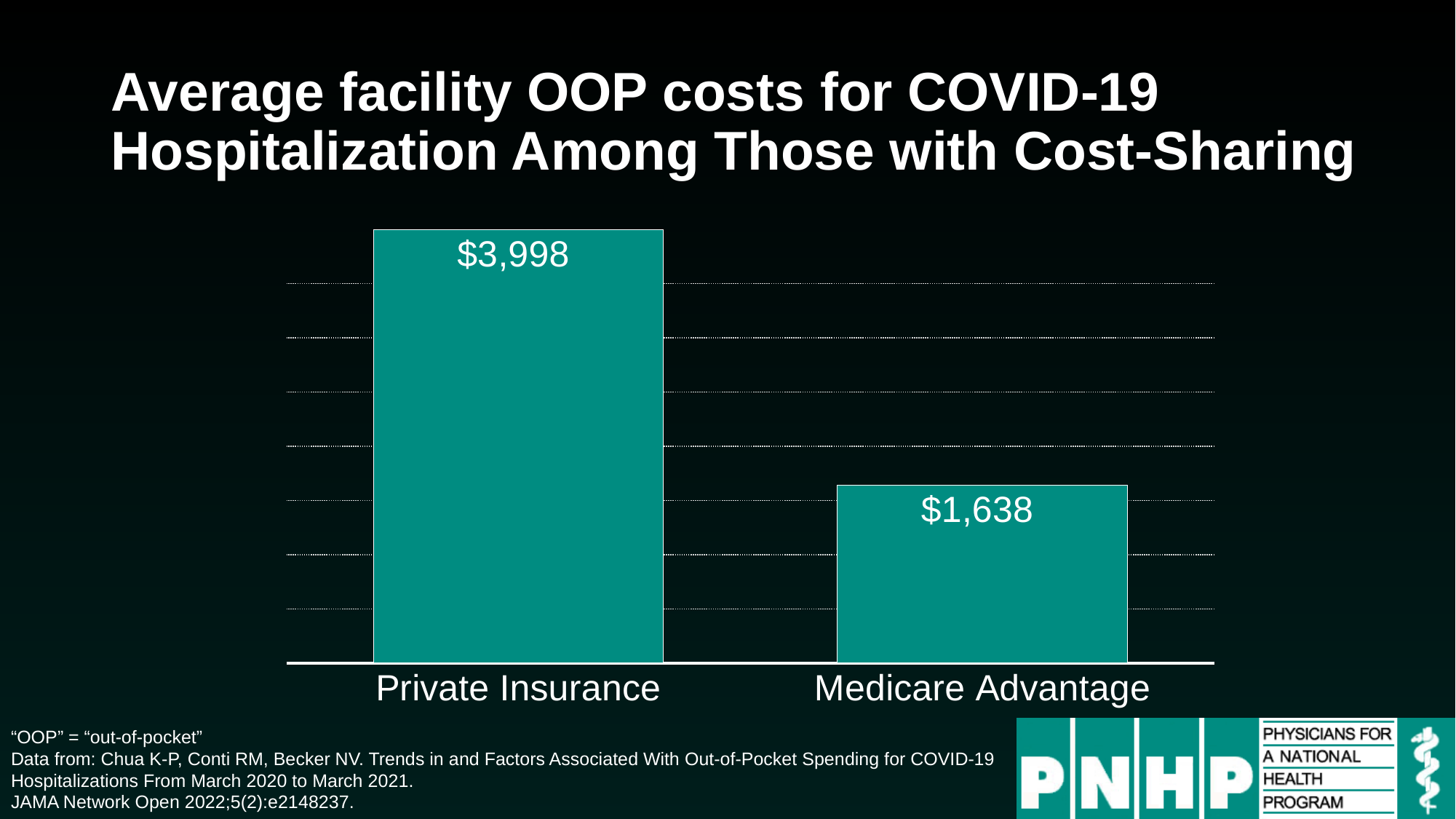
What is the title of the chart on the slide? Average facility OOP costs for COVID-19 Hospitalization Among Those with Cost-Sharing What is the difference between the Private Insurance and Medicare Advantage OOP costs? $2,360 Which is larger, the OOP cost for Private Insurance or for Medicare Advantage? Private Insurance What is the average facility OOP cost for Private Insurance? $3,998 What does "OOP" stand for according to the slide? Out-of-pocket What is the average facility OOP cost for Medicare Advantage? $1,638 How many categories are shown in the chart? 2 Which category has the highest average facility OOP cost? Private Insurance Which category has the lowest average facility OOP cost? Medicare Advantage What kind of chart is shown on the slide? Bar chart